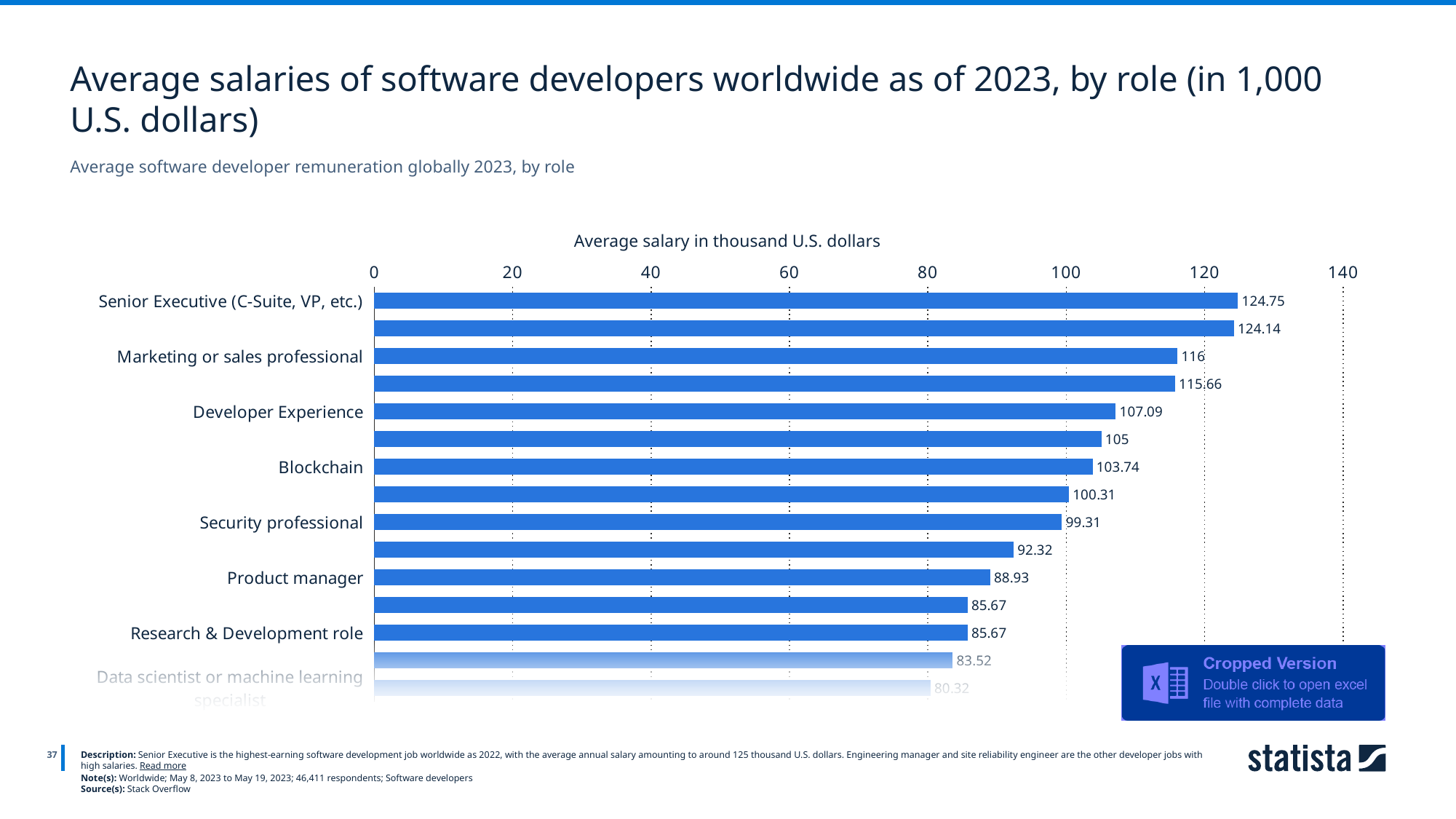
What is the average salary for Product manager? 88.93 Which role has the highest average salary on the chart? Senior Executive (C-Suite, VP, etc.) Is the value for Research & Development role greater or less than 100? less What is the average salary for Marketing or sales professional? 116 What is the average salary for Senior Executive (C-Suite, VP, etc.)? 124.75 What is the title of the horizontal axis of the chart? Average salary in thousand U.S. dollars What is the average salary for Developer Experience? 107.09 What is the average salary for Security professional? 99.31 What kind of chart is shown on the slide? Bar chart What is the average salary for Blockchain? 103.74 Which has a higher average salary, Blockchain or Security professional? Blockchain What is the difference between the average salaries of Senior Executive (C-Suite, VP, etc.) and Marketing or sales professional? 8.75